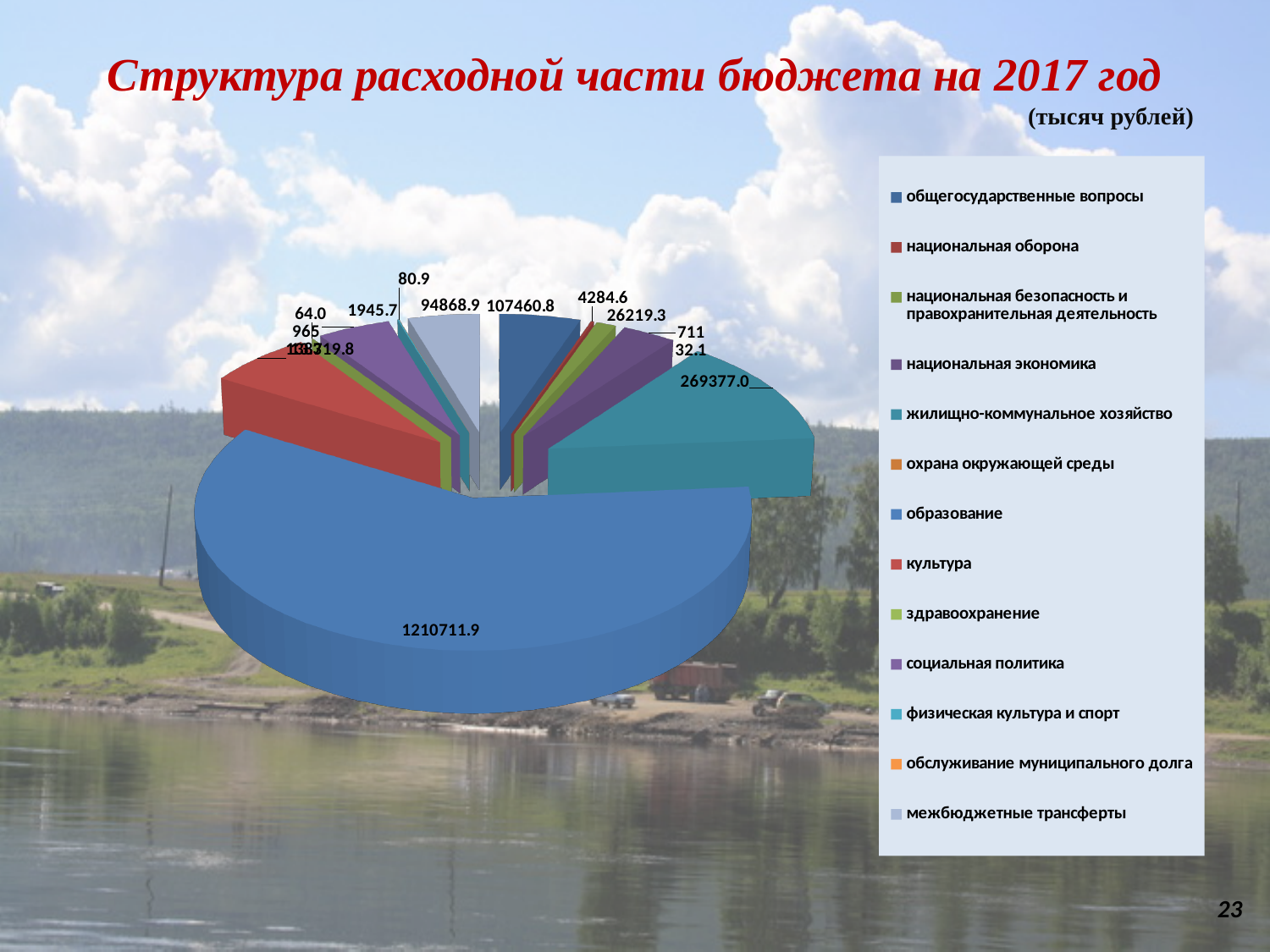
Which category has the largest share of the budget expenditure? образование What kind of chart is shown on the slide? pie chart Which is larger, the value for образование or the value for жилищно-коммунальное хозяйство? образование How many categories does the legend list? 13 What is the difference between the values for образование and жилищно-коммунальное хозяйство? 941334.9 In what units are the values on the chart given? тысяч рублей What is the value for образование? 1210711.9 What is the value for межбюджетные трансферты? 94868.9 What is the value for культура? 138719.8 What is the value for жилищно-коммунальное хозяйство? 269377.0 What is the value for общегосударственные вопросы? 107460.8 What is the title of the chart on the slide? Структура расходной части бюджета на 2017 год